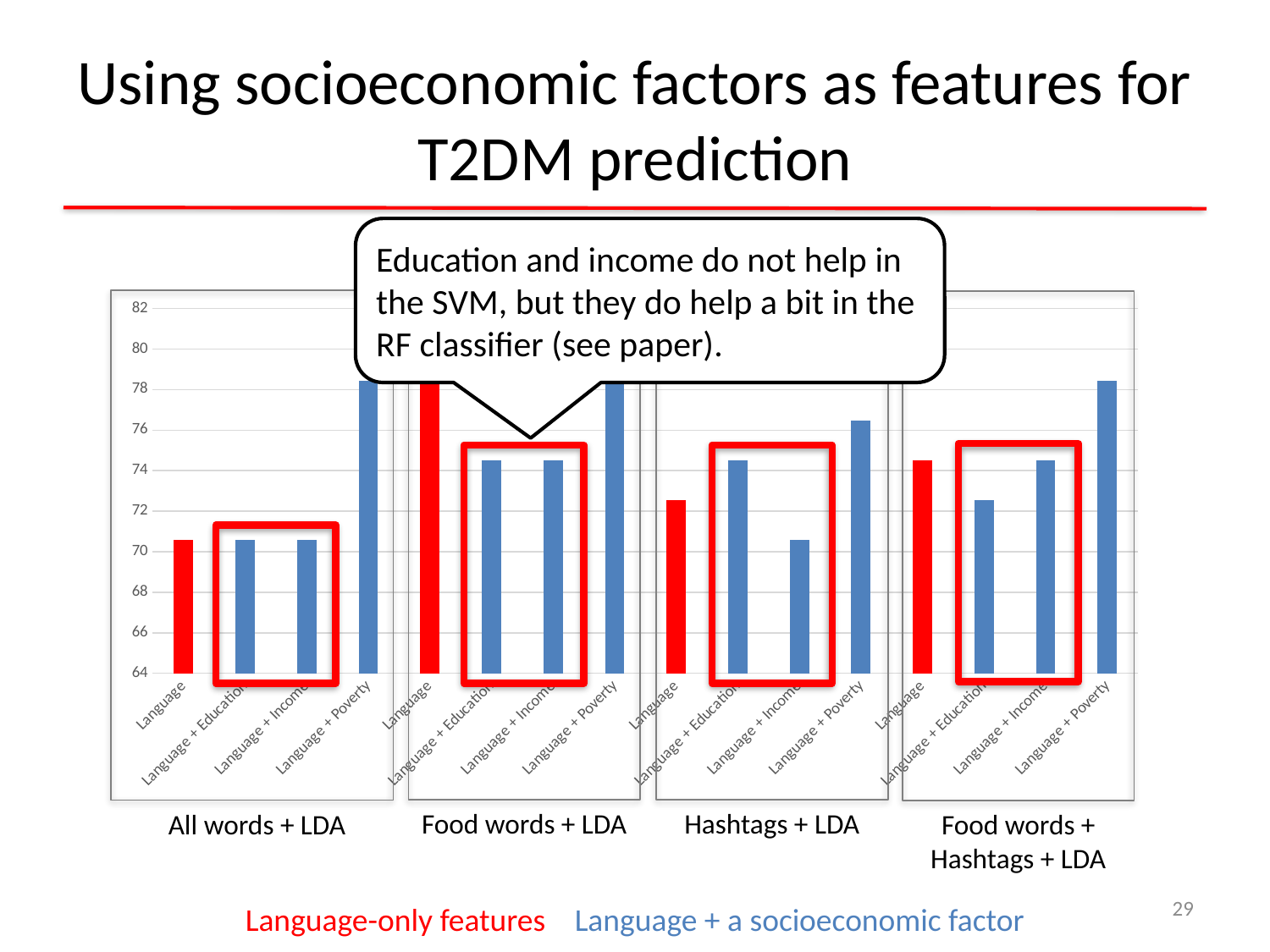
In the 'Food words + LDA' chart, is the value for Language + Education greater or less than 72? greater How many bars are plotted in the 'Hashtags + LDA' chart? 4 In the 'Hashtags + LDA' chart, which category has the highest value? Language + Poverty In the 'Hashtags + LDA' chart, which category has the lowest value? Language + Income In the 'All words + LDA' chart, which category has the highest value? Language + Poverty What kind of chart is the 'All words + LDA' chart? bar chart In the 'Food words + Hashtags + LDA' chart, which category has the lowest value? Language + Education In the 'Hashtags + LDA' chart, which is larger: Language + Education or Language + Income? Language + Education In the 'All words + LDA' chart, is the value for Language + Poverty greater or less than 76? greater In the 'Food words + Hashtags + LDA' chart, which is larger: Language + Poverty or Language + Education? Language + Poverty In the 'Hashtags + LDA' chart, is the value for Language + Income greater or less than 72? less In the 'Food words + Hashtags + LDA' chart, which category has the highest value? Language + Poverty